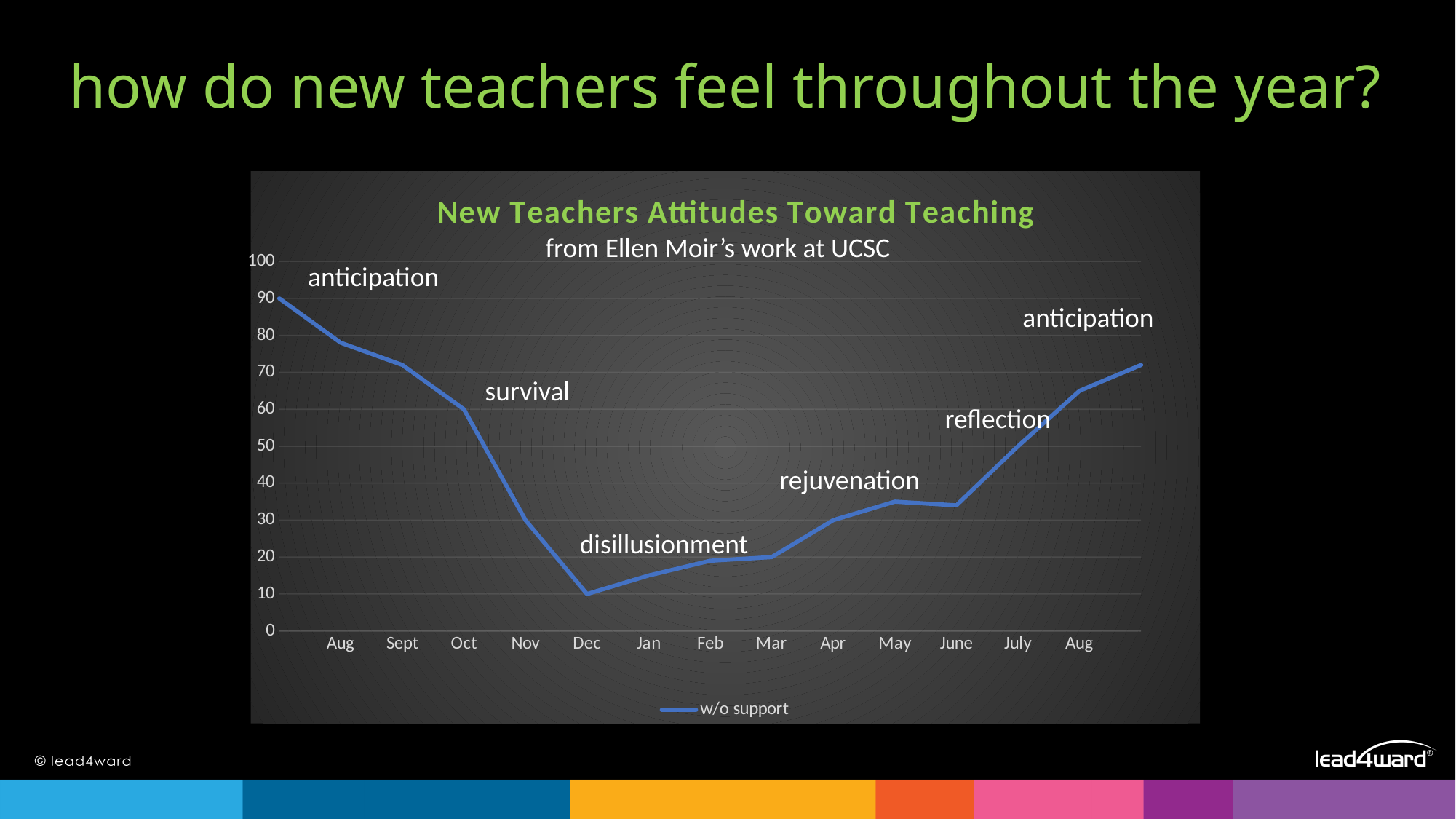
Is the value for Jan greater or less than 20? less What is the title of the chart? New Teachers Attitudes Toward Teaching In which month does the line reach its lowest value? Dec How many series does the legend list? 1 How many month labels are shown on the x axis? 13 What is the name of the series shown in the legend? w/o support Is the value for Oct greater or less than 50? greater Does the line rise or fall from Aug to Dec? fall Is the value for Nov greater or less than 40? less Which is larger, the value for Sept or the value for Nov? Sept What kind of chart is shown on the slide? line chart